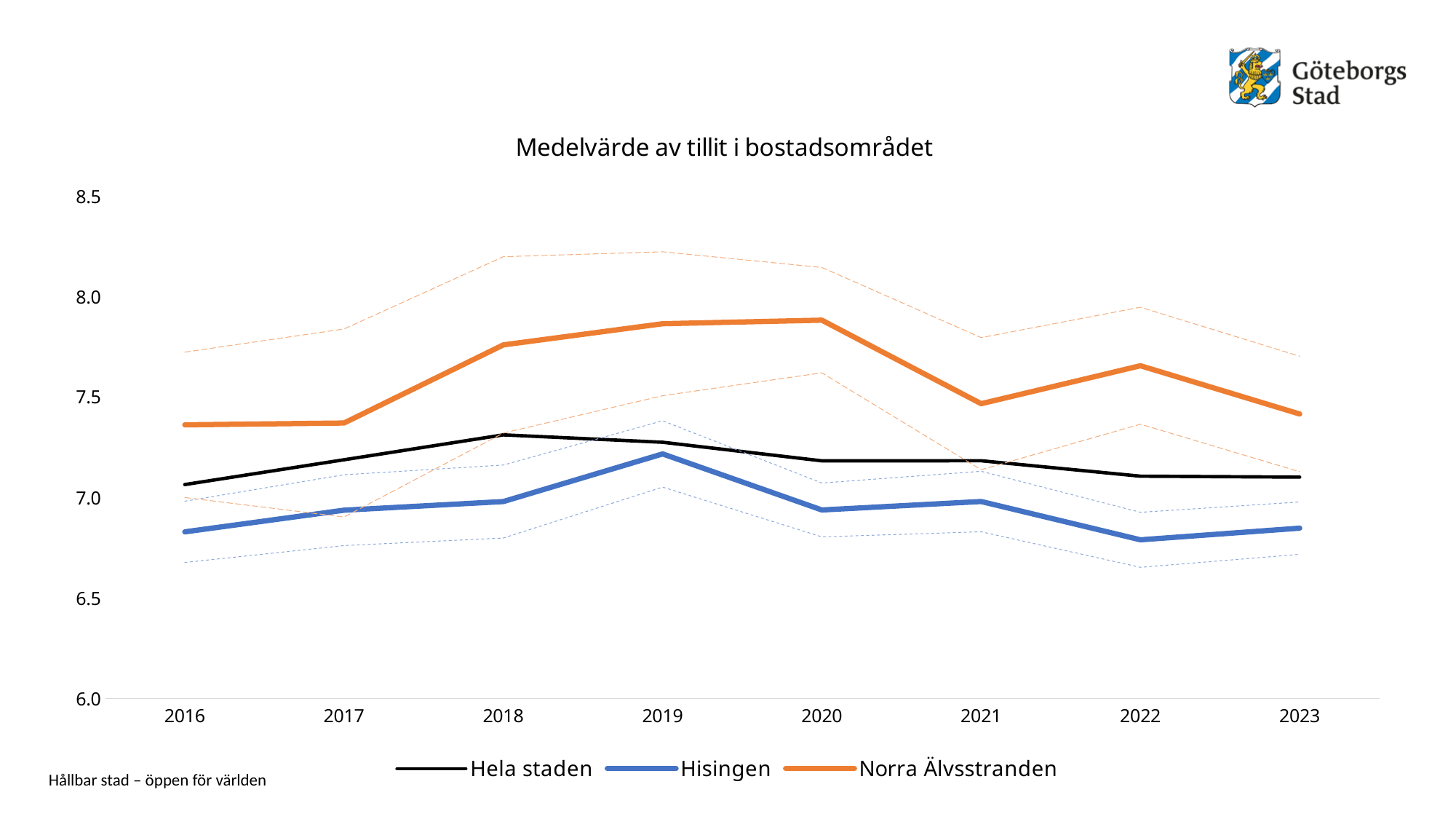
In which year does Hisingen reach its highest value? 2019 Is the value for Norra Älvsstranden in 2020 greater or less than 7.5? greater Does the Norra Älvsstranden line rise or fall from 2017 to 2020? rise What is the title of the chart? Medelvärde av tillit i bostadsområdet Is the value for Hisingen in 2019 greater or less than 7.0? greater How many years are shown on the x axis? 8 Which series has the highest value in 2023? Norra Älvsstranden How many series does the legend list? 3 In 2016, which is higher: Hela staden or Hisingen? Hela staden Which series is drawn in orange? Norra Älvsstranden Is the value for Hisingen in 2016 greater or less than 7.0? less What kind of chart is shown on the slide? line chart